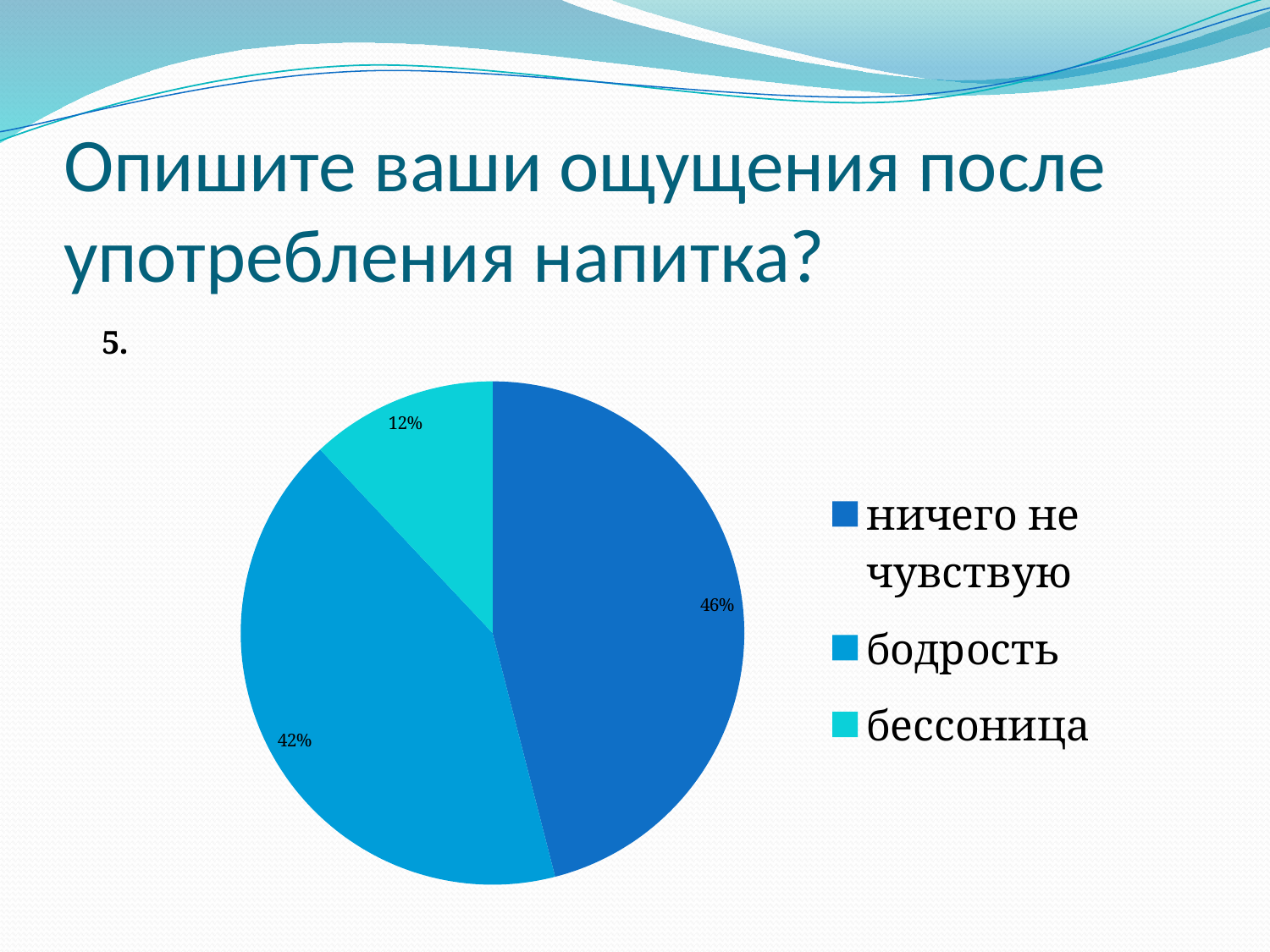
What share of the pie does "бессоница" have? 12% What kind of chart is shown on the slide? pie chart What share of the pie does "бодрость" have? 42% Which category has the smallest slice of the pie? бессоница What is the difference in percentage points between "бодрость" and "бессоница"? 30 Which is larger, the slice for "бодрость" or the slice for "бессоница"? бодрость What share of the pie does "ничего не чувствую" have? 46% What colour is the slice for "бессоница"? light blue (cyan) Which category has the largest slice of the pie? ничего не чувствую What is the difference in percentage points between "ничего не чувствую" and "бодрость"? 4 How many categories does the pie chart have? 3 How many entries does the legend list? 3